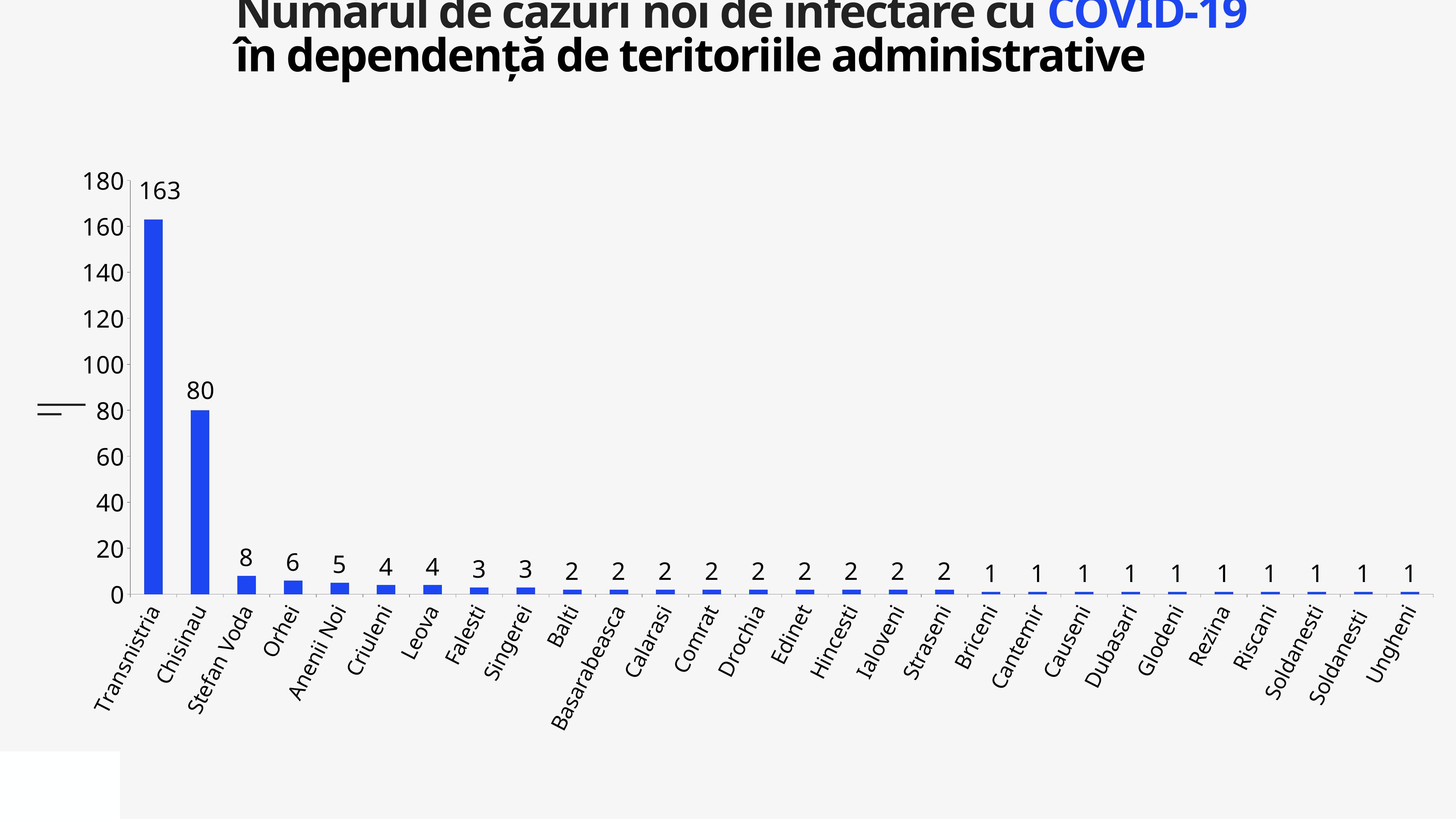
Which territory has the highest value? Transnistria What is the value for Anenii Noi? 5 What is the value for Transnistria? 163 What kind of chart is shown on the slide? bar chart What is the value for Chisinau? 80 How many categories are shown on the x axis? 28 Do the values rise or fall from left to right along the x axis? fall Which is larger, the value for Chisinau or the value for Stefan Voda? Chisinau Is the value for Transnistria greater or less than 140? greater What is the difference between the values for Transnistria and Chisinau? 83 What is the value for Stefan Voda? 8 What is the value for Orhei? 6